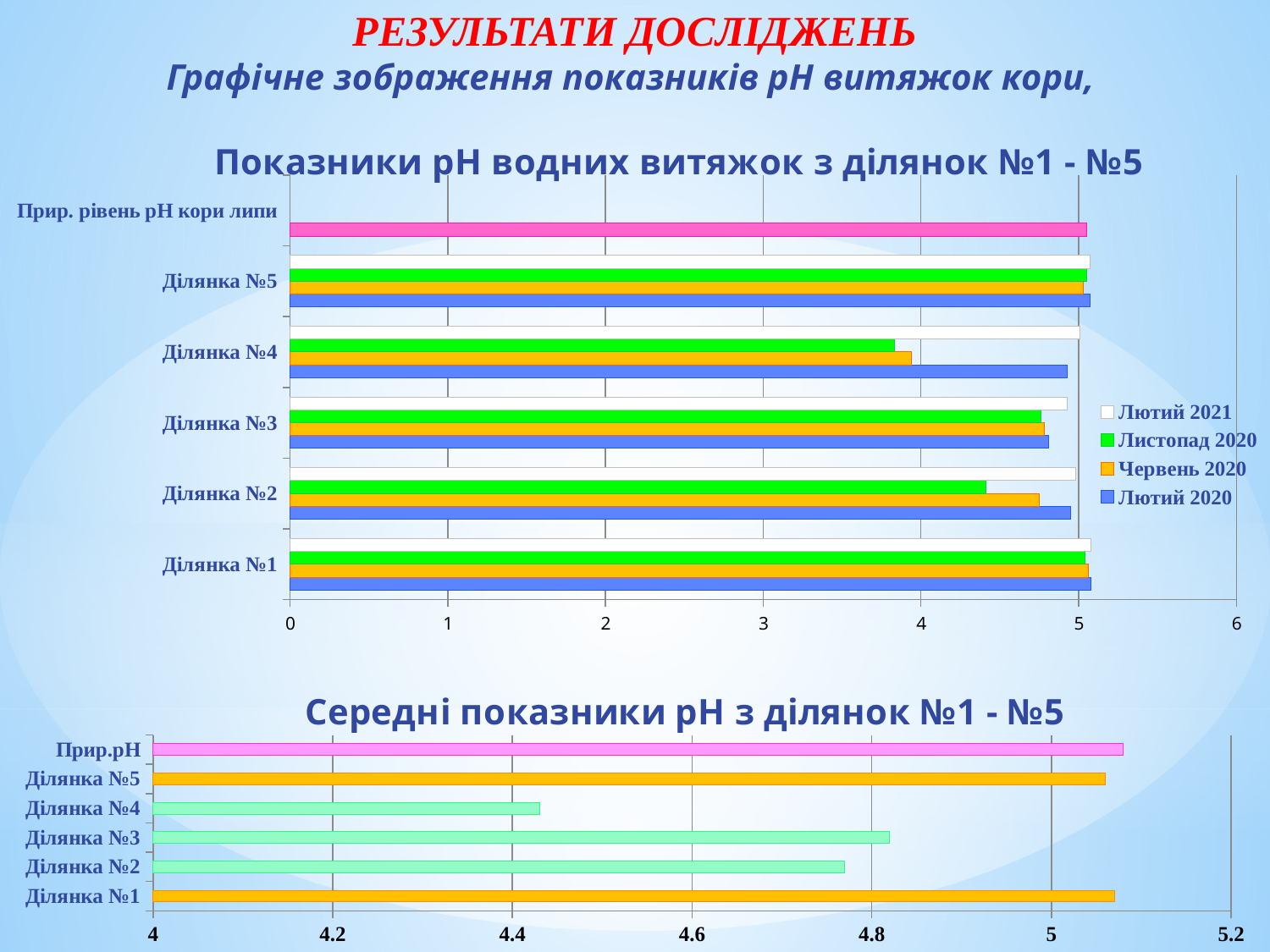
In the top chart 'Показники pH водних витяжок з ділянок №1 - №5', how many series does the legend list? 4 In the top chart 'Показники pH водних витяжок з ділянок №1 - №5', is the Листопад 2020 value for Ділянка №4 greater or less than 4? less In the top chart 'Показники pH водних витяжок з ділянок №1 - №5', which series is shown in green in the legend? Листопад 2020 In the bottom chart 'Середні показники pH з ділянок №1 - №5', is the value for Ділянка №4 greater or less than 4.6? less In the bottom chart 'Середні показники pH з ділянок №1 - №5', which is larger: the value for Ділянка №3 or the value for Ділянка №4? Ділянка №3 In the top chart 'Показники pH водних витяжок з ділянок №1 - №5', how many categories are shown on the vertical axis? 6 What kind of chart is the top chart titled 'Показники pH водних витяжок з ділянок №1 - №5'? bar chart In the bottom chart 'Середні показники pH з ділянок №1 - №5', is the value for Ділянка №5 greater or less than 5? greater In the top chart 'Показники pH водних витяжок з ділянок №1 - №5', for Ділянка №4, which is larger: the Лютий 2020 value or the Листопад 2020 value? Лютий 2020 In the bottom chart 'Середні показники pH з ділянок №1 - №5', which category has the lowest value? Ділянка №4 In the bottom chart 'Середні показники pH з ділянок №1 - №5', how many bars are shown? 6